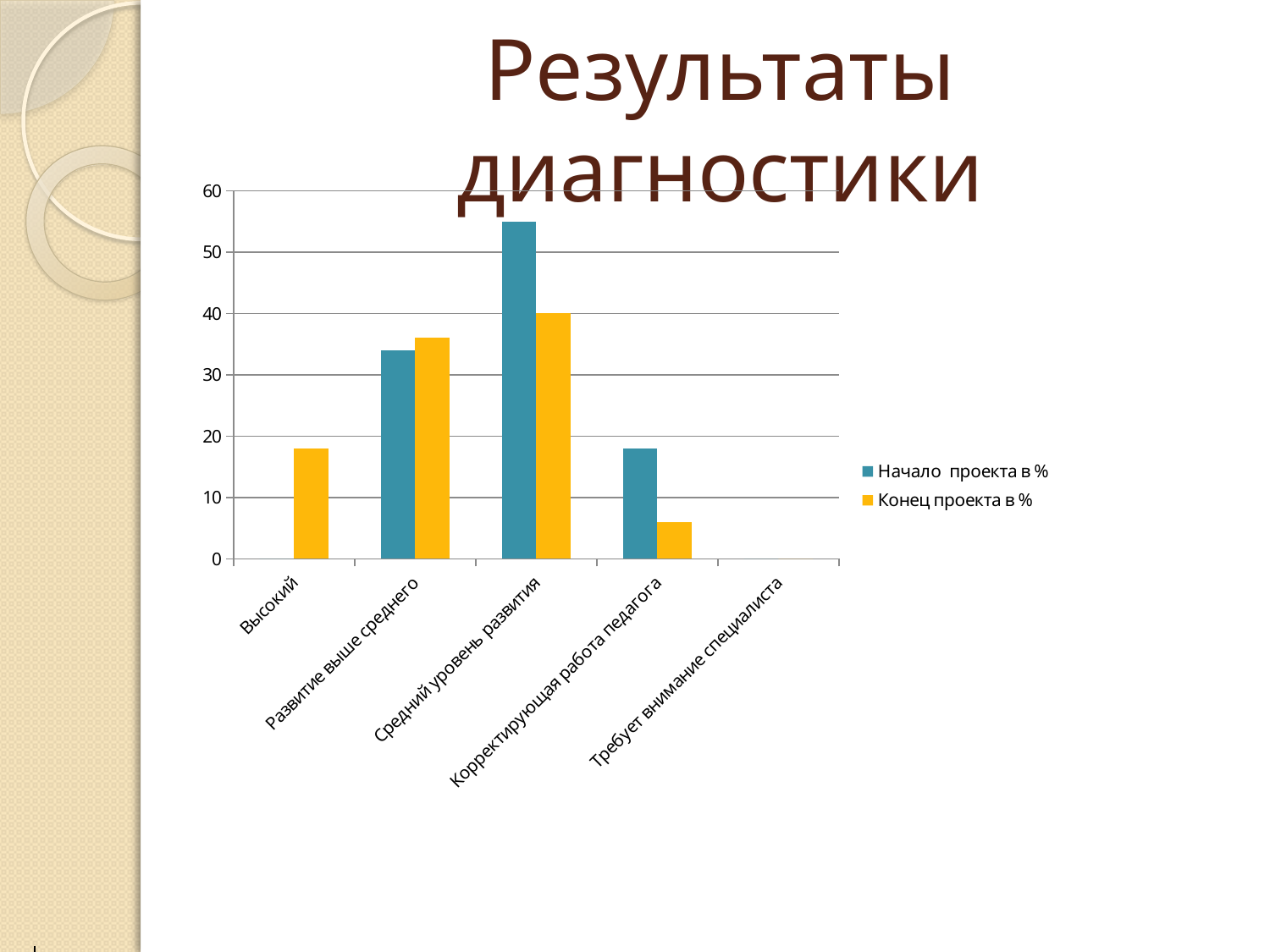
Is the value of 'Начало проекта в %' for 'Развитие выше среднего' greater or less than 30? greater How many series does the legend list? 2 For 'Средний уровень развития', which series has the larger value: 'Начало проекта в %' or 'Конец проекта в %'? Начало проекта в % Is the value of 'Начало проекта в %' for 'Средний уровень развития' greater or less than 50? greater Which category has the highest value for the series 'Конец проекта в %'? Средний уровень развития How many categories are shown on the x axis? 5 For 'Корректирующая работа педагога', which series has the larger value: 'Начало проекта в %' or 'Конец проекта в %'? Начало проекта в % Is the value of 'Конец проекта в %' for 'Высокий' greater or less than 20? less What kind of chart is shown on the slide? bar chart What are the two series names listed in the legend? Начало проекта в %; Конец проекта в % Which category has the highest value for the series 'Начало проекта в %'? Средний уровень развития